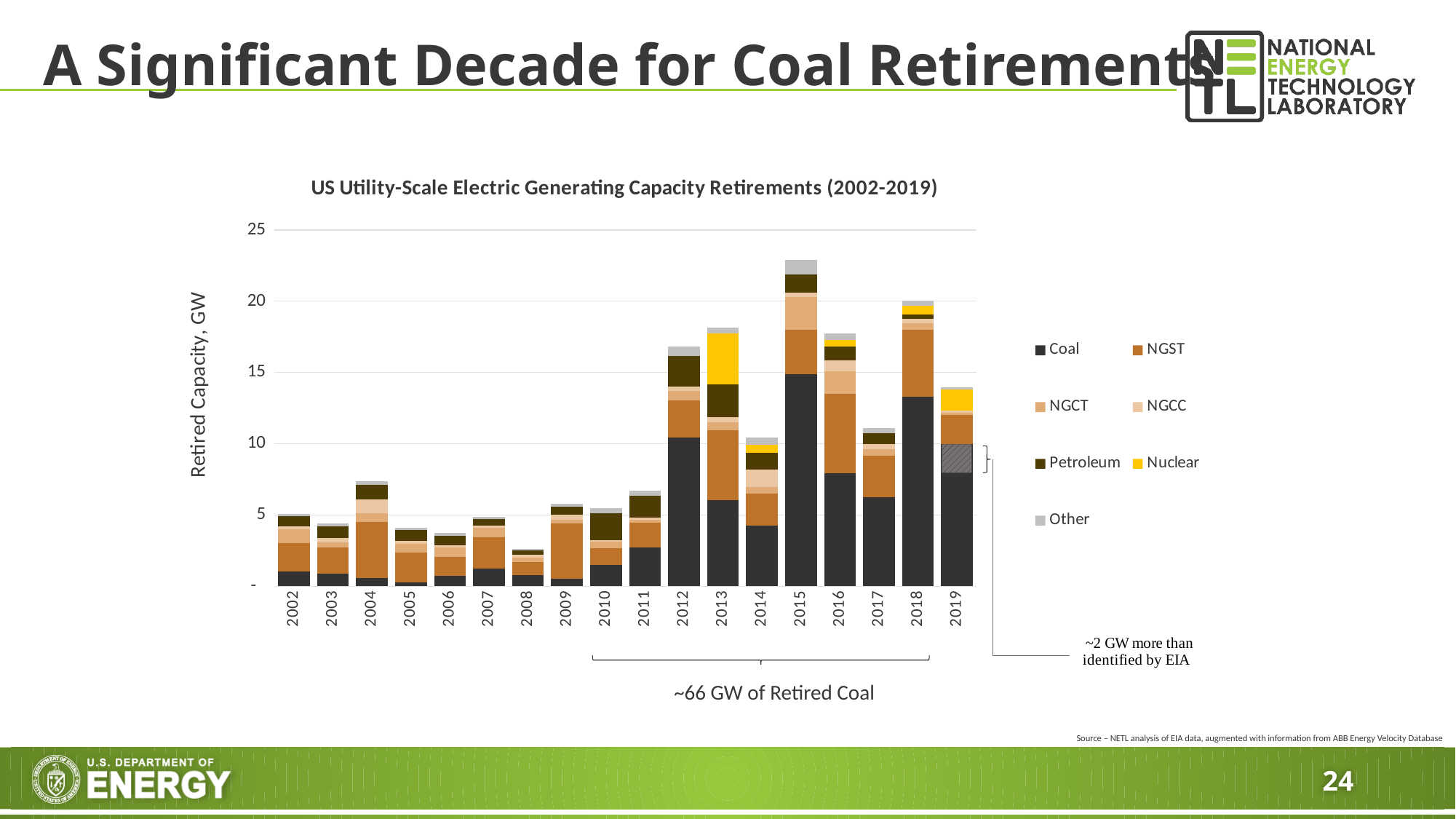
What is the title of the chart? US Utility-Scale Electric Generating Capacity Retirements (2002-2019) Which year has a larger total retired capacity, 2004 or 2005? 2004 Is the total retired capacity for 2015 greater or less than 20 GW? greater Which year has the lowest total retired capacity? 2008 Does the total retired capacity rise or fall from 2015 to 2017? fall What kind of chart is shown on the slide? Stacked bar chart How many series does the chart legend list? 7 Is the total retired capacity for 2019 greater or less than 15 GW? less Is the total retired capacity for 2008 greater or less than 5 GW? less How many years are shown along the x axis of the chart? 18 Which year has the highest total retired capacity? 2015